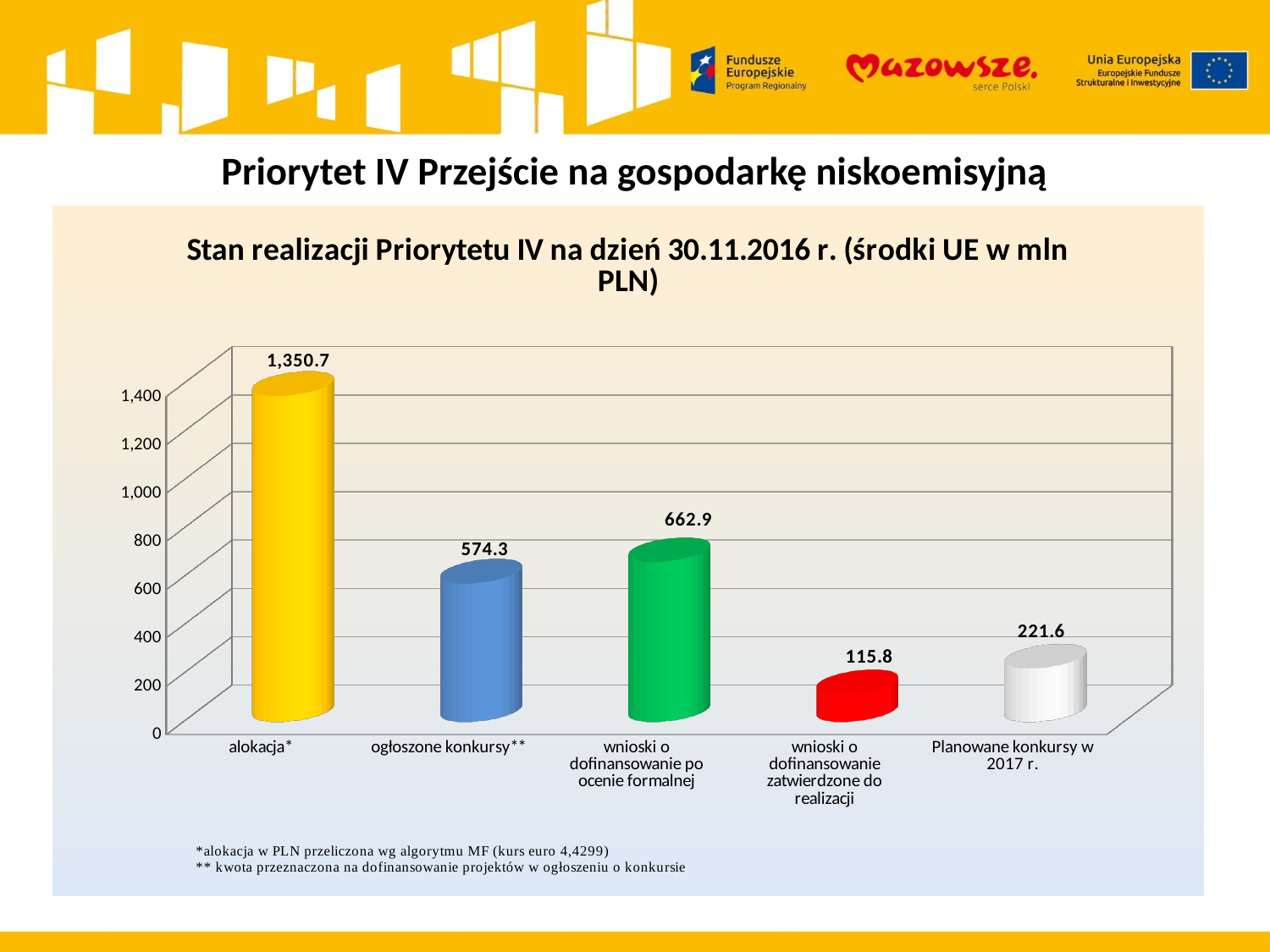
Which category has the lowest value? wnioski o dofinansowanie zatwierdzone do realizacji What is the value for wnioski o dofinansowanie zatwierdzone do realizacji? 115.8 What is the value for ogłoszone konkursy**? 574.3 Which category has the highest value? alokacja* What is the difference between the values for alokacja* and ogłoszone konkursy**? 776.4 How many categories are shown on the chart? 5 What is the value for alokacja*? 1,350.7 What is the value for Planowane konkursy w 2017 r.? 221.6 What is the title of the chart? Stan realizacji Priorytetu IV na dzień 30.11.2016 r. (środki UE w mln PLN) What kind of chart is shown on the slide? bar chart What is the value for wnioski o dofinansowanie po ocenie formalnej? 662.9 Which is larger: the value for ogłoszone konkursy** or the value for wnioski o dofinansowanie po ocenie formalnej? wnioski o dofinansowanie po ocenie formalnej